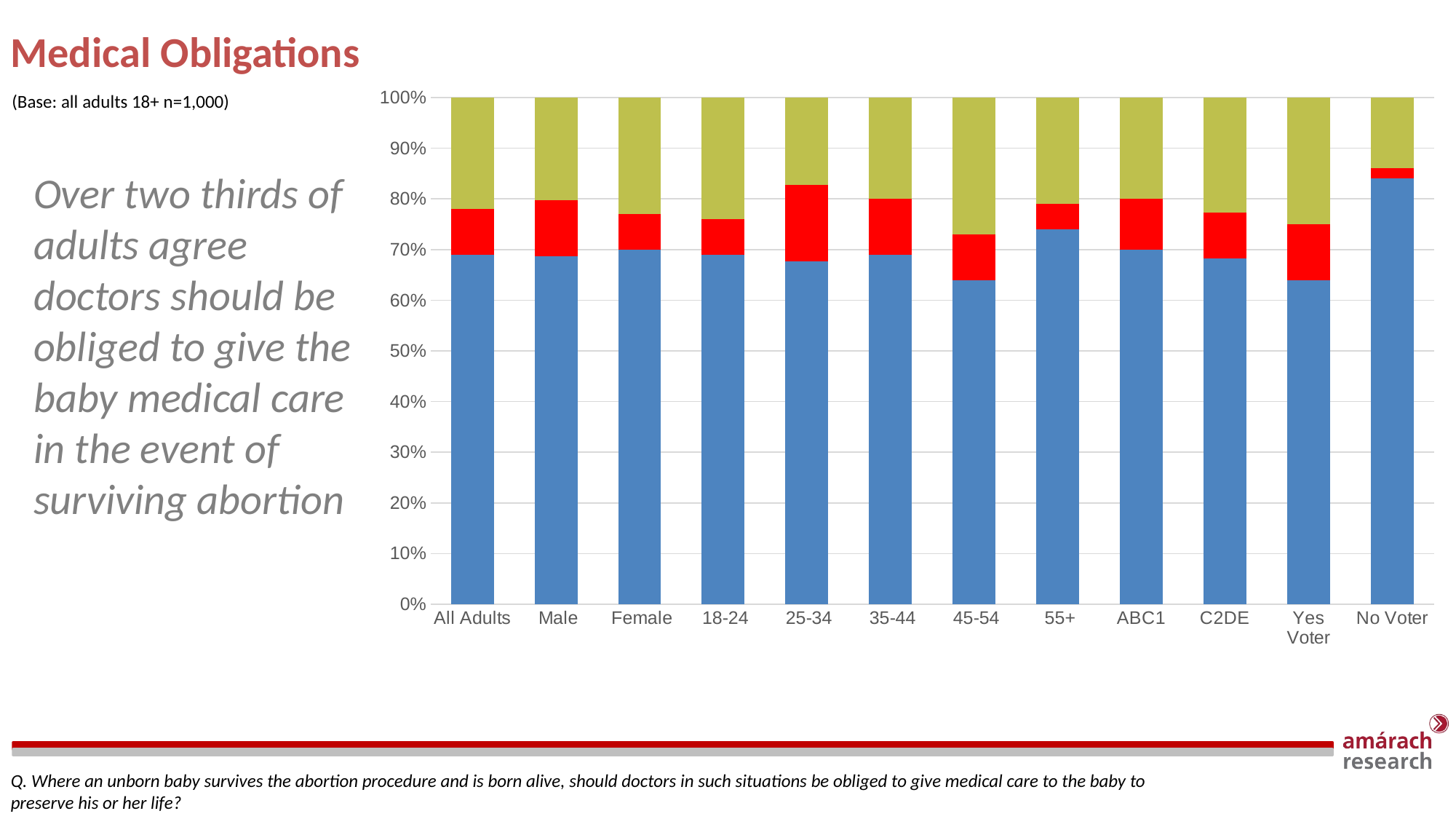
Which has the larger blue segment, No Voter or Yes Voter? No Voter Is the blue segment for Yes Voter greater or less than 70%? less How many differently coloured segments make up each stacked bar? 3 What is the title of the slide containing the chart? Medical Obligations Is the blue segment for 45-54 greater or less than 70%? less Is the blue segment for 55+ greater or less than 70%? greater What is the total height of the stacked bar for All Adults? 100% What kind of chart is shown on the slide? Stacked bar chart Which has the larger blue segment, 55+ or 45-54? 55+ How many categories are shown along the x axis of the chart? 12 Which category has the largest blue (bottom) segment? No Voter